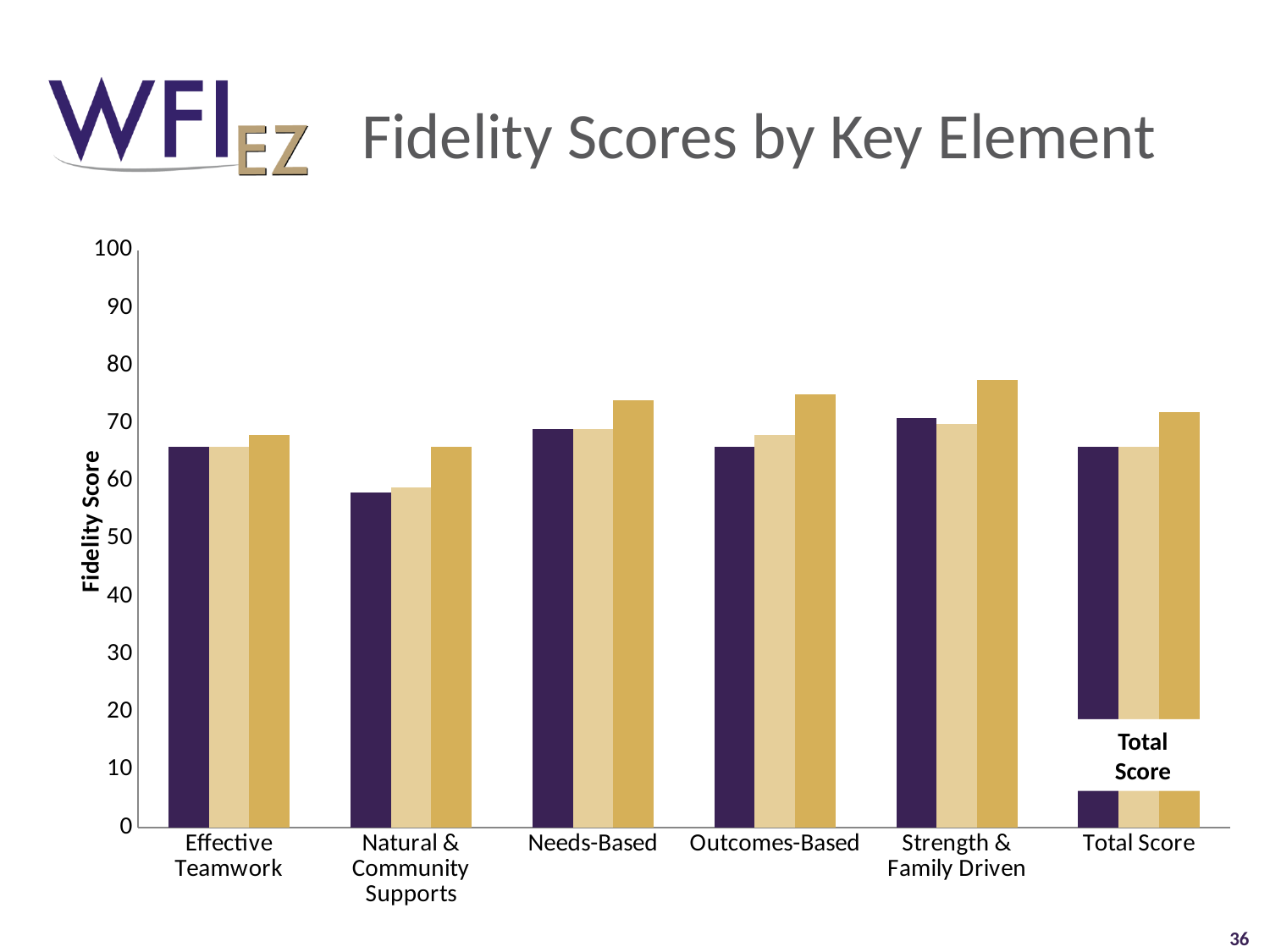
What is the title of the chart? Fidelity Scores by Key Element Is the gold bar for Strength & Family Driven greater or less than 70? greater What is the label on the vertical axis of the chart? Fidelity Score Which is larger: the gold bar for Outcomes-Based or the gold bar for Effective Teamwork? Outcomes-Based Which category has the lowest dark purple bar? Natural & Community Supports How many bars are plotted for each category in the chart? 3 What type of chart is shown on the slide? bar chart How many categories are shown along the x axis of the chart? 6 Which is larger: the dark purple bar for Needs-Based or the dark purple bar for Natural & Community Supports? Needs-Based Is the dark purple bar for Natural & Community Supports greater or less than 60? less Is the gold bar for Needs-Based greater or less than 80? less